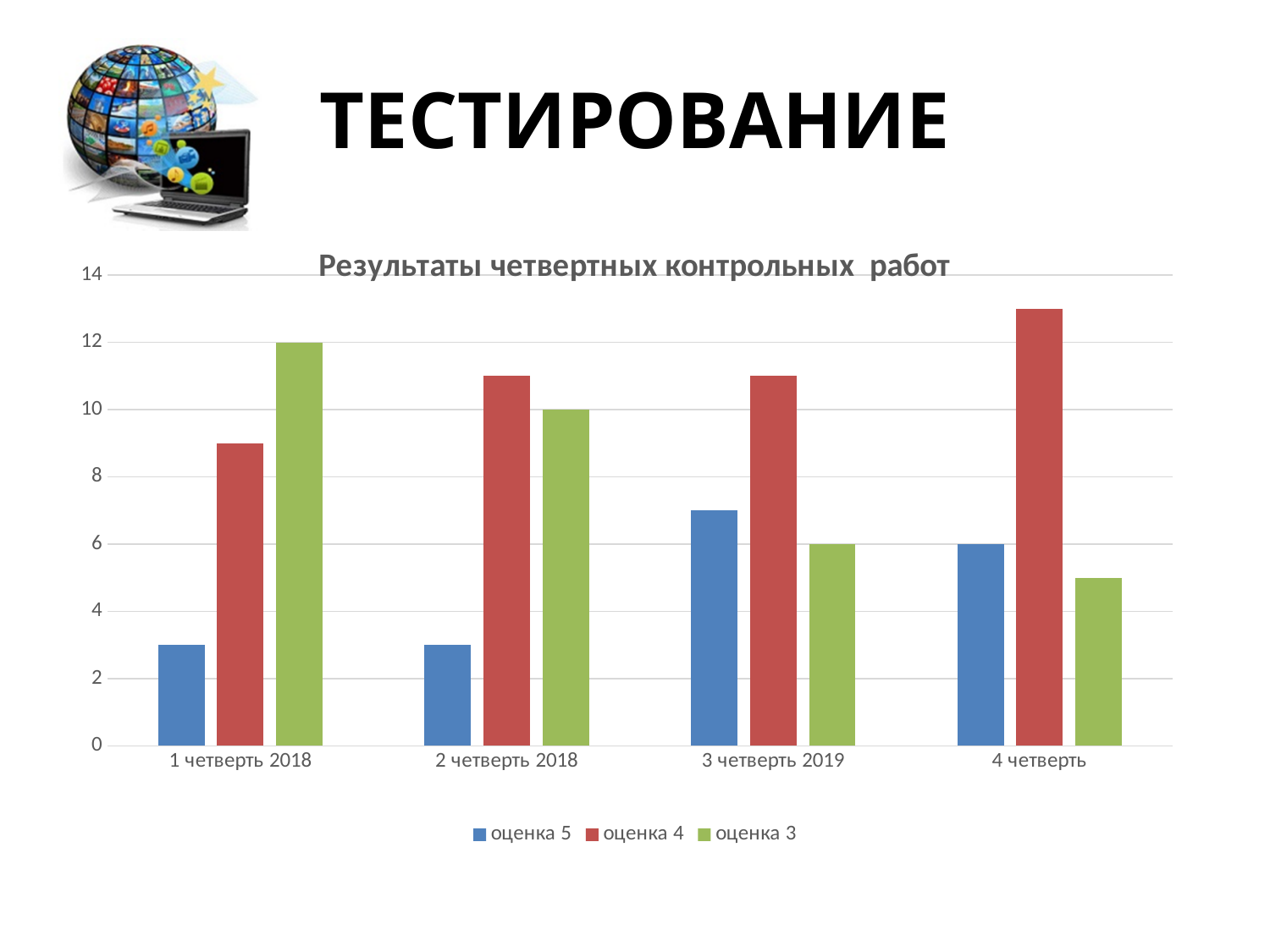
What is the title of the chart? Результаты четвертных контрольных работ What type of chart is shown on the slide? bar chart How many series does the legend list? 3 In which category is оценка 4 highest? 4 четверть What is the value of оценка 3 for 2 четверть 2018? 10 How many categories are shown on the x axis? 4 What is the value of оценка 5 for 4 четверть? 6 Does the value of оценка 3 rise or fall across the quarters from 1 четверть 2018 to 4 четверть? fall What is the value of оценка 3 for 1 четверть 2018? 12 In which category is оценка 3 lowest? 4 четверть Is the value of оценка 5 for 1 четверть 2018 greater or less than 4? less Is the value of оценка 4 for 4 четверть greater or less than 12? greater